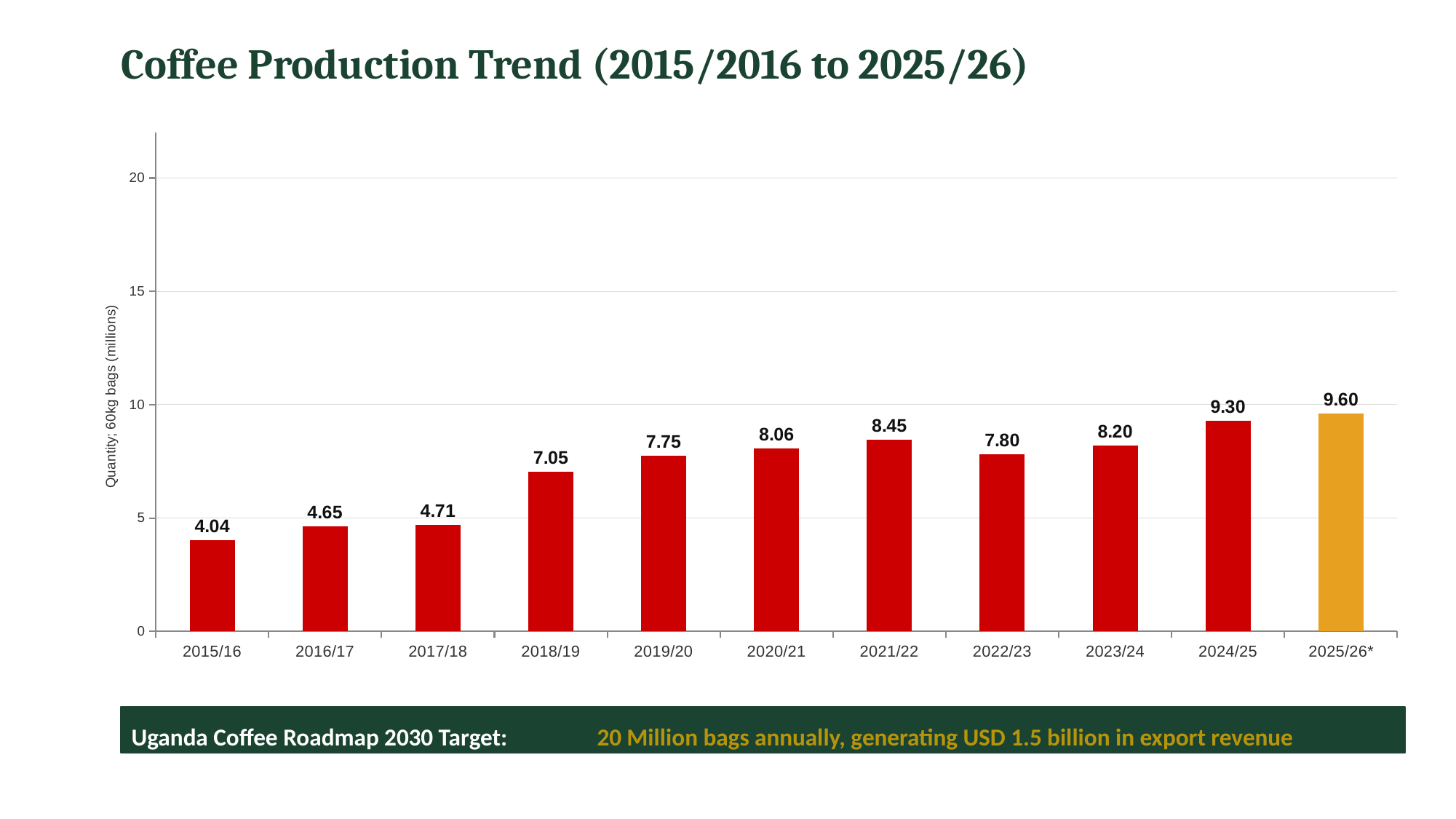
Is the value for 2019/20 greater or less than 5? greater Which year has the lowest coffee production value? 2015/16 Which is larger, the value for 2021/22 or the value for 2022/23? 2021/22 Which bar is coloured differently from the others? 2025/26* What is the difference between the values for 2025/26* and 2015/16? 5.56 Do the values generally rise or fall from 2015/16 to 2025/26*? rise Which year has the highest coffee production value? 2025/26* What is the value shown for 2024/25? 9.30 How many years are shown on the x axis? 11 What kind of chart is shown on the slide? bar chart What is the coffee production value for 2018/19? 7.05 What is the label of the y axis? Quantity; 60kg bags (millions)